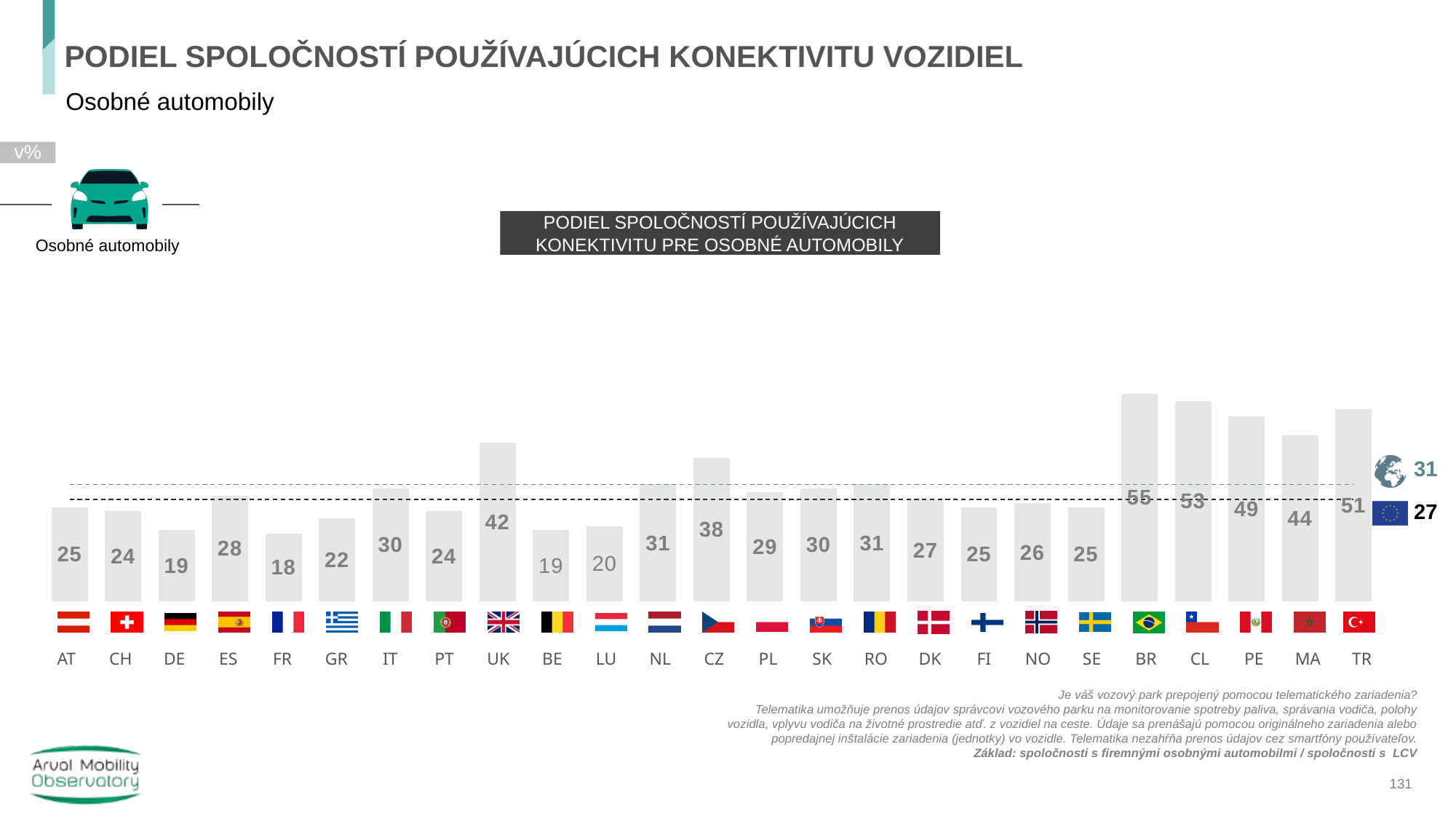
Which country has the lowest value? FR What value is shown next to the EU flag on the right of the chart? 27 What is the difference between the values for BR and CL? 2 What is the value for UK? 42 What is the difference between the values for UK and DE? 23 What is the value for CZ? 38 How many countries are shown on the chart? 25 What is the value for FR? 18 What kind of chart is shown on the slide? bar chart What is the value for MA? 44 Which is larger, the value for PE or the value for TR? TR Which country has the highest value? BR